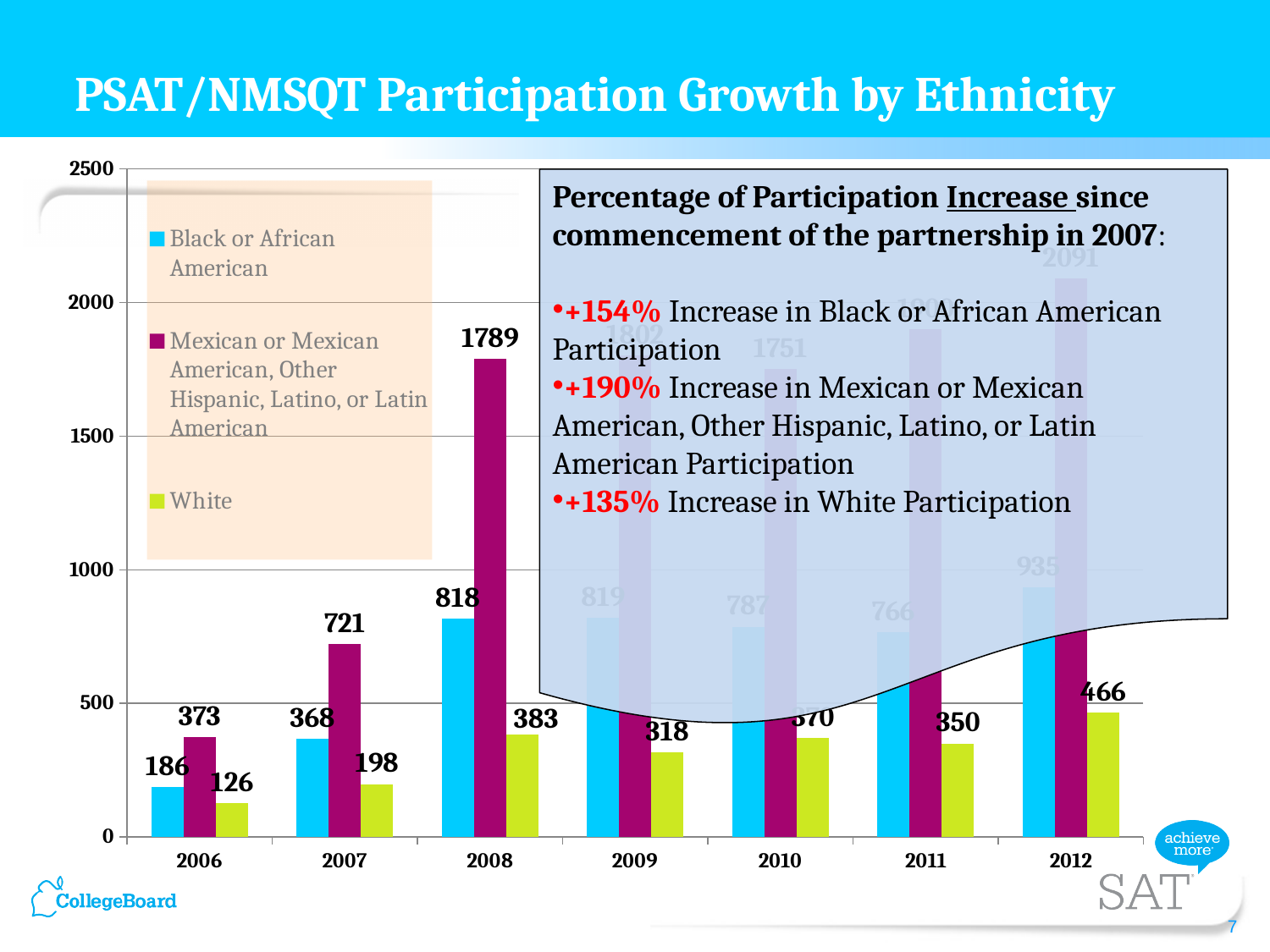
How many series does the legend list? 3 What is the value for Black or African American participation in 2006? 186 How many years are shown on the x axis? 7 Is the value for the Mexican or Mexican American, Other Hispanic, Latino, or Latin American series in 2012 greater or less than 2000? greater What is the difference between the Mexican or Mexican American, Other Hispanic, Latino, or Latin American values in 2008 and 2007? 1068 What kind of chart is shown on the slide? bar chart What is the value for the White series in 2012? 466 What is the value for the White series in 2007? 198 In 2008, which is larger: the Black or African American value or the White value? Black or African American What is the value for the Mexican or Mexican American, Other Hispanic, Latino, or Latin American series in 2008? 1789 In which year is the Mexican or Mexican American, Other Hispanic, Latino, or Latin American series highest? 2012 In which year is the White series lowest? 2006